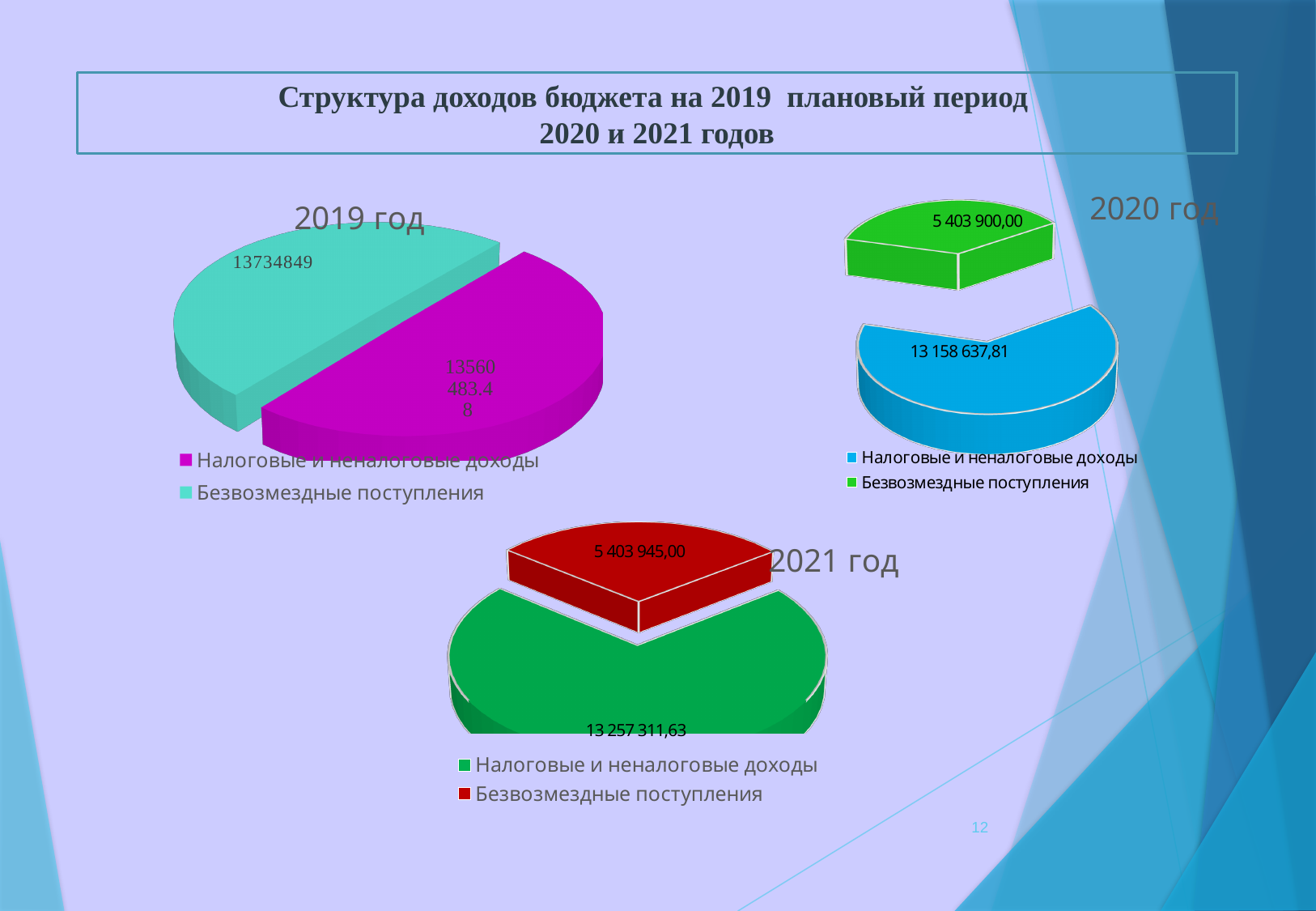
What kind of chart is used for 2019 год? Pie chart In the 2021 год pie chart, which category has the smallest value? Безвозмездные поступления How many slices does the 2021 год pie chart have? 2 In the 2021 год pie chart, what is the value for Налоговые и неналоговые доходы? 13 257 311,63 In the 2020 год pie chart, what is the difference between Налоговые и неналоговые доходы and Безвозмездные поступления? 7 754 737,81 In the 2021 год chart, what colour is the Безвозмездные поступления slice? Red In the 2019 год pie chart, what is the value for Безвозмездные поступления? 13734849 In the 2021 год pie chart, what is the total of the two slices? 18 661 256,63 In the 2020 год pie chart, what is the value for Налоговые и неналоговые доходы? 13 158 637,81 In the 2020 год pie chart, which category has the largest value? Налоговые и неналоговые доходы In the 2020 год pie chart, what is the value for Безвозмездные поступления? 5 403 900,00 In the 2021 год pie chart, what is the value for Безвозмездные поступления? 5 403 945,00